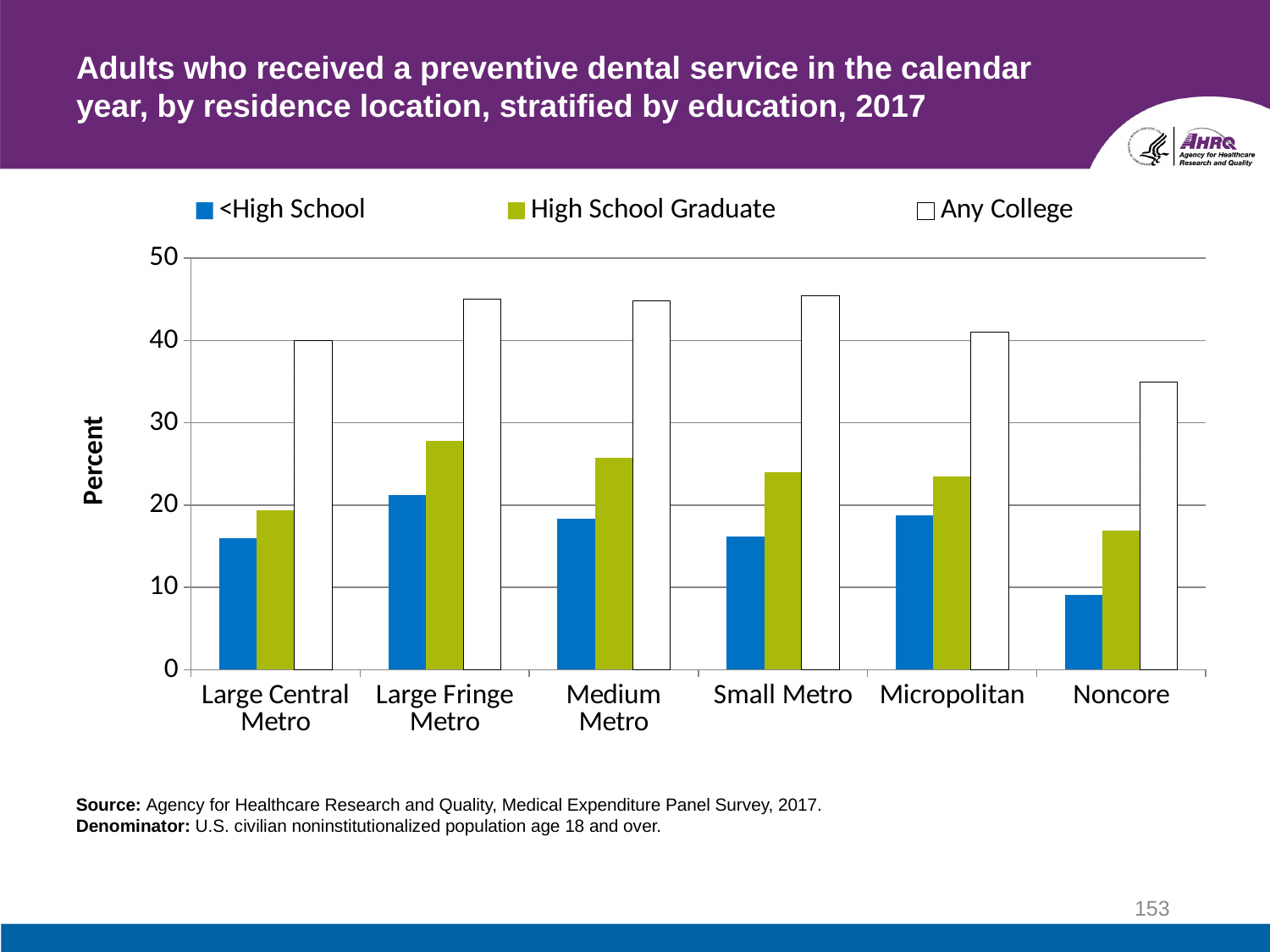
Is the Any College value for Large Fringe Metro greater or less than 40? greater Which is larger, the Any College value for Large Central Metro or for Noncore? Large Central Metro Is the High School Graduate value for Medium Metro greater or less than 20? greater What is the label on the y axis? Percent Which is larger, the High School Graduate value for Large Fringe Metro or for Micropolitan? Large Fringe Metro Which residence location has the lowest value for Any College? Noncore What kind of chart is shown on the slide? bar chart How many residence location categories are shown on the x axis? 6 Which residence location has the lowest value for <High School? Noncore Is the <High School value for Noncore greater or less than 10? less How many series does the legend list? 3 Which residence location has the highest value for High School Graduate? Large Fringe Metro